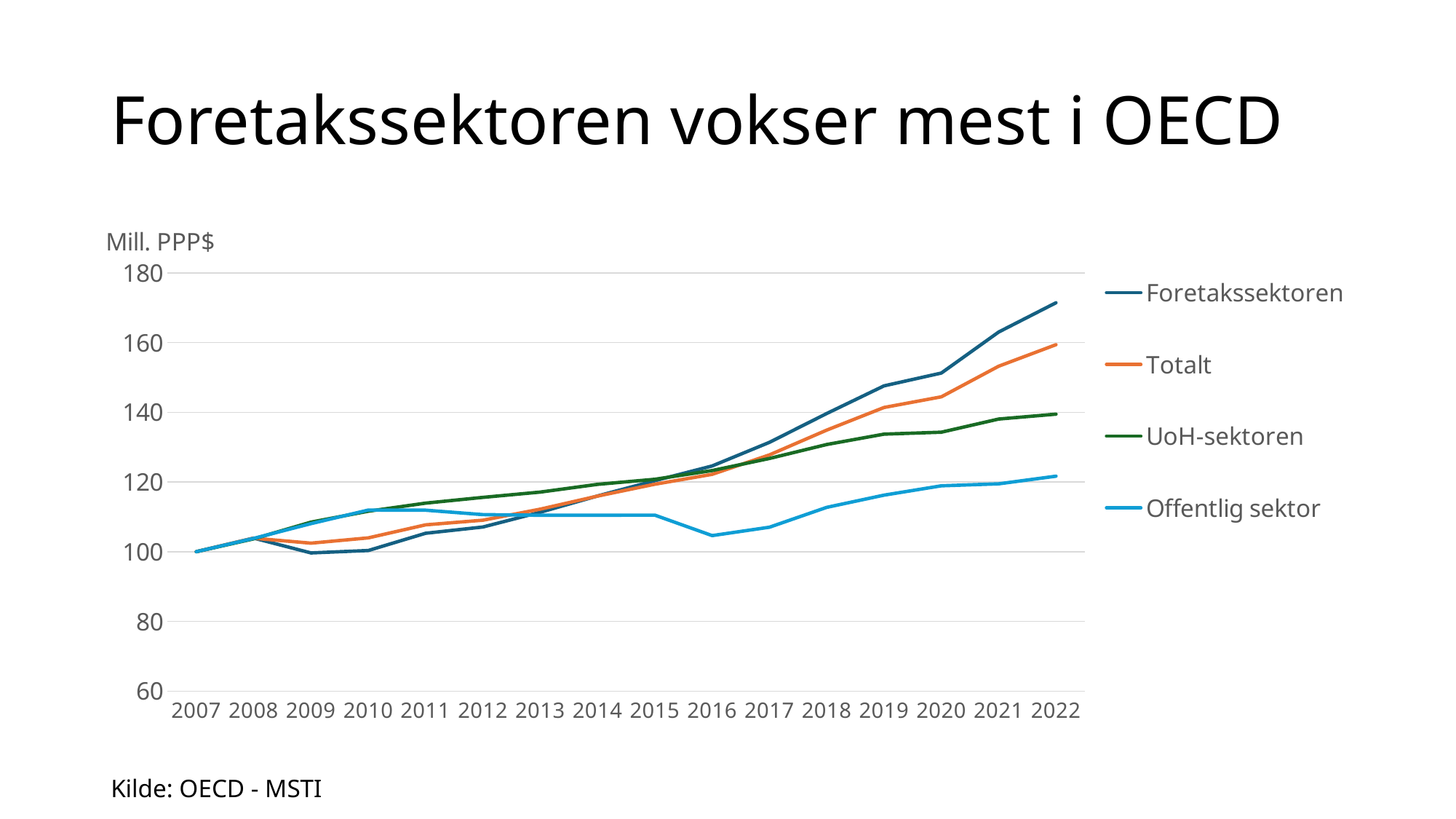
What unit is shown above the y axis? Mill. PPP$ Is the value for UoH-sektoren in 2022 greater or less than 120? greater Which series has the highest value in 2022? Foretakssektoren Which series has the lowest value in 2022? Offentlig sektor Is the value for Offentlig sektor in 2022 greater or less than 140? less How many series does the legend list? 4 What is the value for Foretakssektoren in 2007? 100 Is the value for Foretakssektoren in 2022 greater or less than 160? greater What kind of chart is shown on the slide? line chart In 2022, which is larger: Totalt or UoH-sektoren? Totalt How many years are shown along the x axis? 16 Does the Foretakssektoren line rise or fall from 2010 to 2022? rise